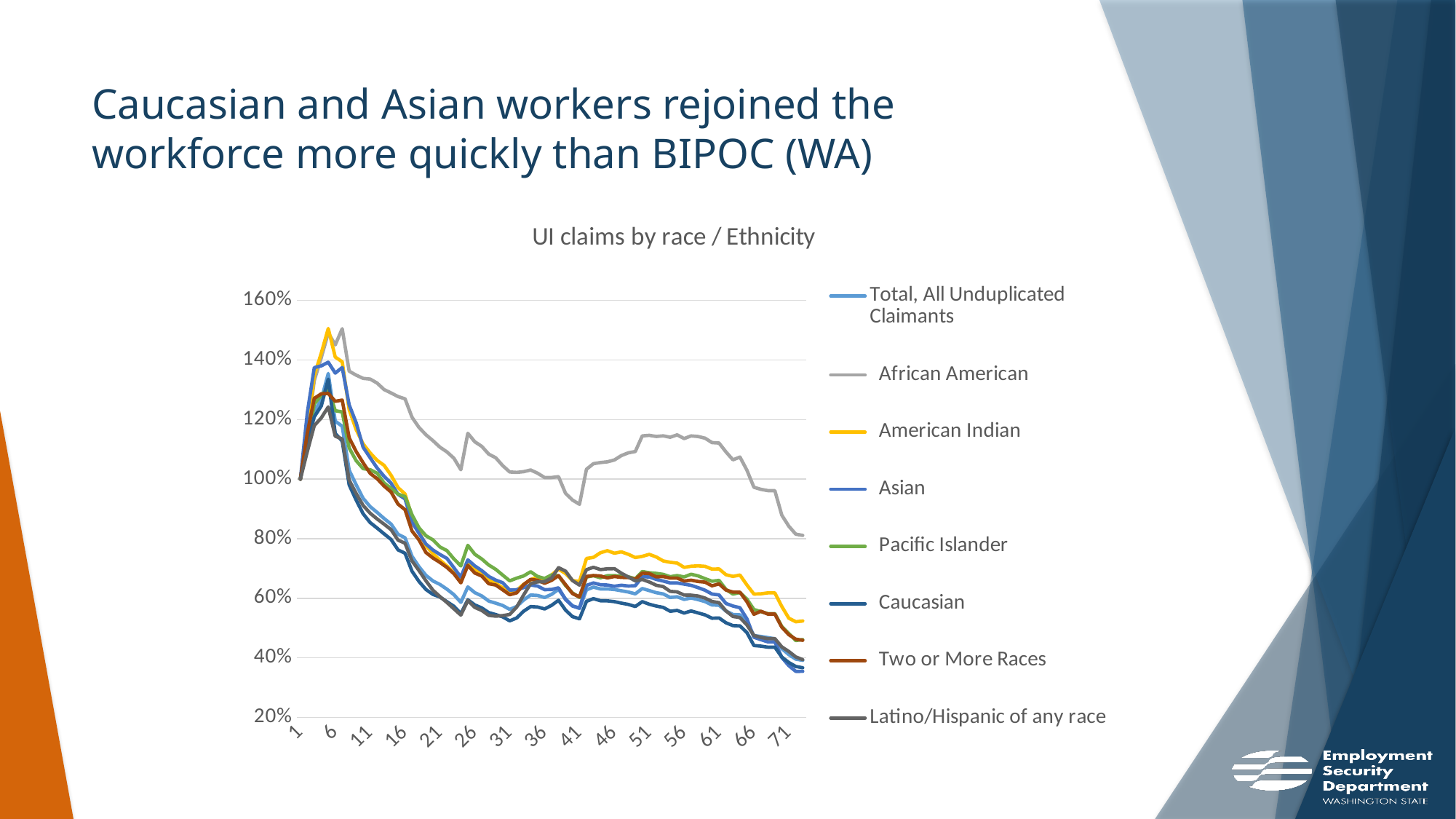
What is the highest value shown on the y axis of the chart? 160% What kind of chart is shown on the slide? Line chart Is the value for American Indian at point 46 greater or less than 60%? greater Which series has the highest value at the far right end of the chart? African American At what value do all the series start at point 1 on the x axis? 100% Overall, do the values in the chart rise or fall from the start to the end of the x axis? Fall At the far right end of the chart, which is larger: the value for African American or the value for Caucasian? African American Which series is drawn in gray in the chart? African American Is the value for Caucasian at the far right end of the chart greater or less than 40%? less How many series does the legend of the 'UI claims by race / Ethnicity' chart list? 8 What is the title of the chart? UI claims by race / Ethnicity Is the value for African American at point 51 greater or less than 100%? greater